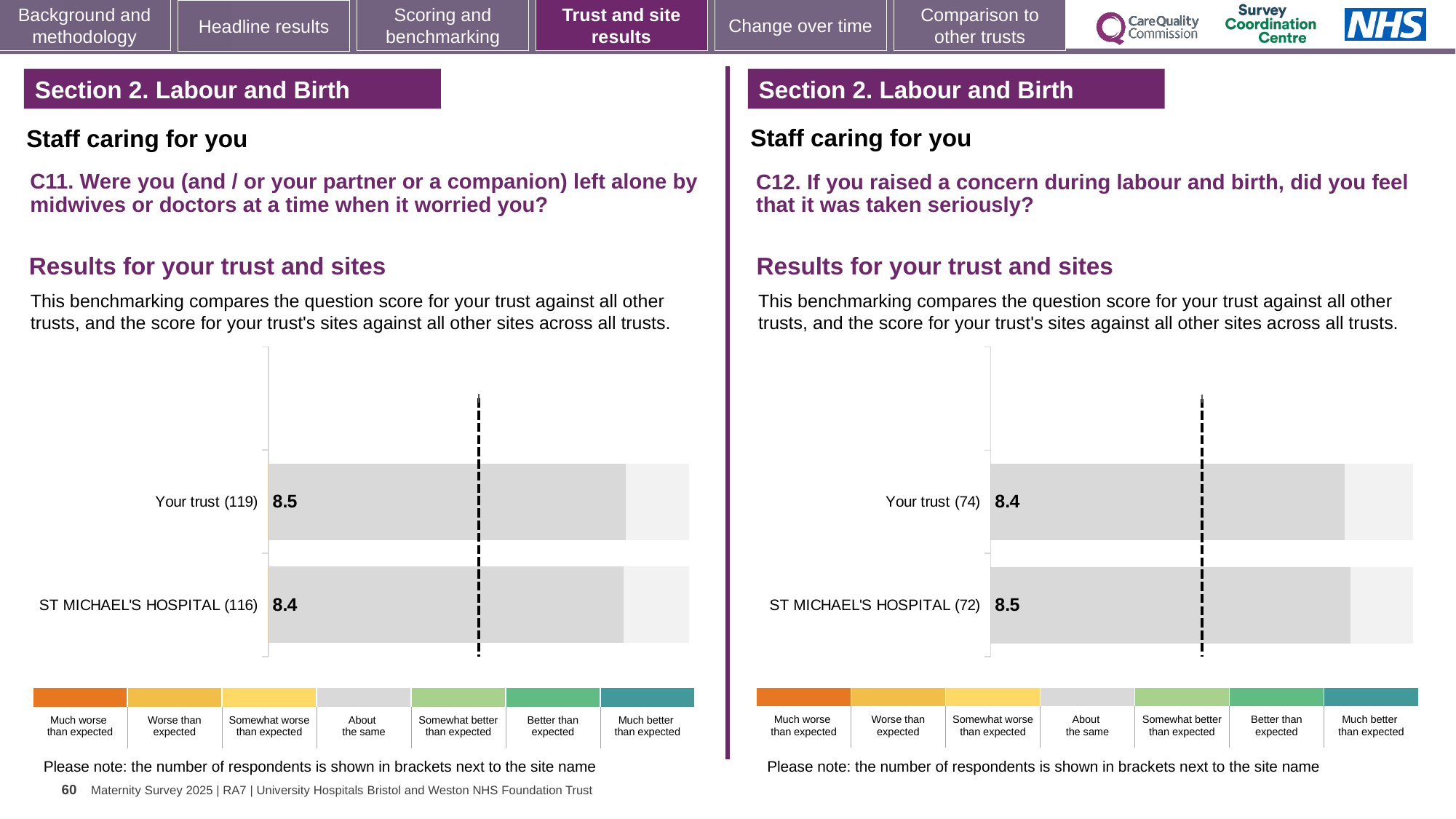
In the C11 chart on the left, what is the score for ST MICHAEL'S HOSPITAL? 8.4 In the C12 chart on the right, which has the lower score, Your trust or ST MICHAEL'S HOSPITAL? Your trust In the C11 chart on the left, how many respondents are shown in brackets for Your trust? 119 In the C12 chart on the right, what is the difference between the scores for ST MICHAEL'S HOSPITAL and Your trust? 0.1 In the C12 chart on the right, what is the score for Your trust? 8.4 In the C11 chart on the left, which has the higher score, Your trust or ST MICHAEL'S HOSPITAL? Your trust In the C12 chart on the right, what is the score for ST MICHAEL'S HOSPITAL? 8.5 In the C11 chart on the left, what is the score for Your trust? 8.5 In the C11 chart on the left, what is the difference between the scores for Your trust and ST MICHAEL'S HOSPITAL? 0.1 How many bars are plotted in the C11 chart on the left? 2 What type of chart is used for the C12 results on the right? Bar chart In the C12 chart on the right, how many respondents are shown in brackets for ST MICHAEL'S HOSPITAL? 72